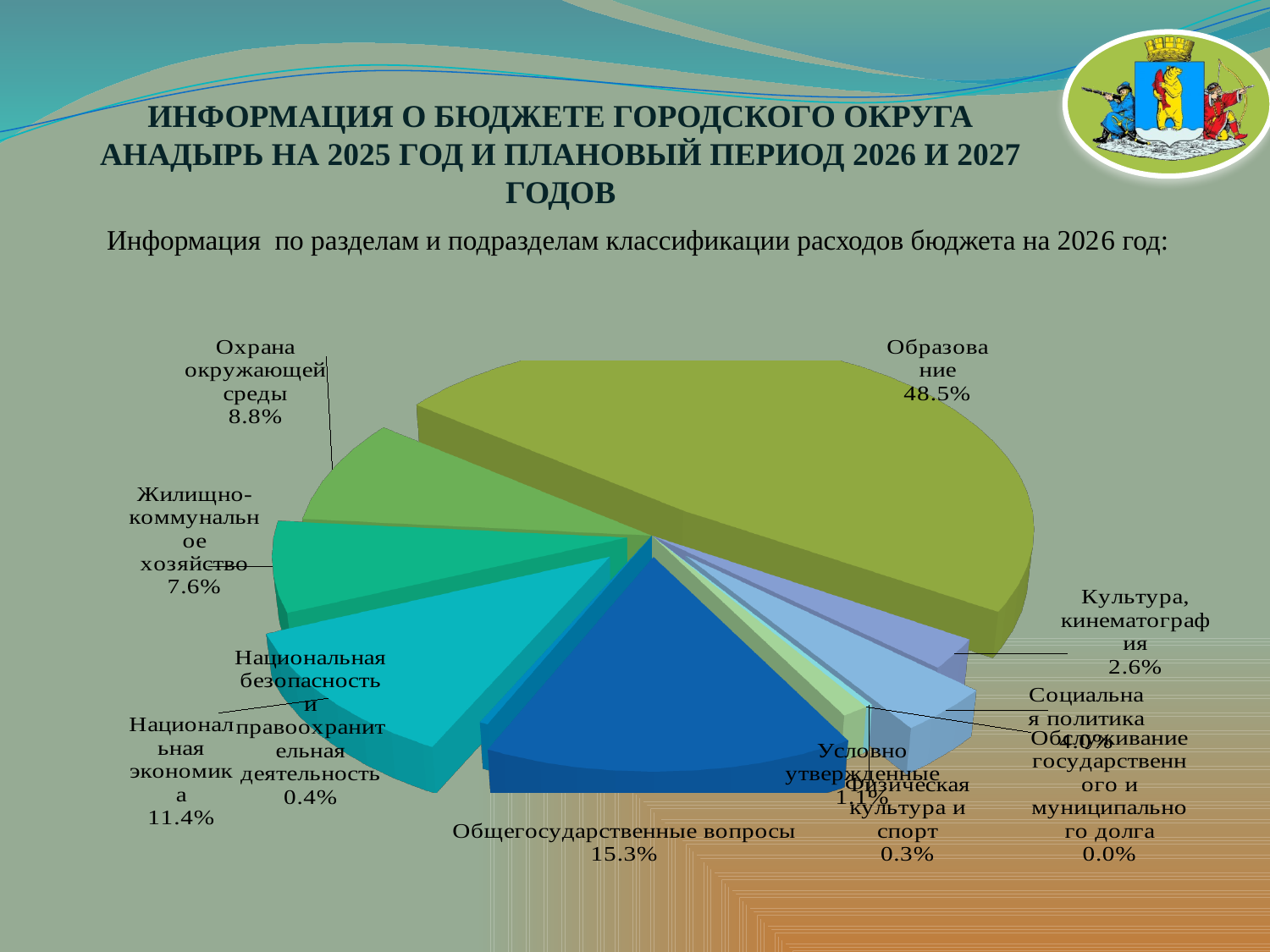
Which is larger, Охрана окружающей среды or Жилищно-коммунальное хозяйство? Охрана окружающей среды What is the value shown for Охрана окружающей среды? 8.8% What is the value shown for Обслуживание государственного и муниципального долга? 0.0% How many categories are shown in the pie chart? 11 What is the value shown for Общегосударственные вопросы? 15.3% What is the difference in percentage points between Образование and Общегосударственные вопросы? 33.2 What is the value shown for Культура, кинематография? 2.6% What is the value shown for Национальная экономика? 11.4% What share of the pie does Образование have? 48.5% Which category has the largest share of the pie? Образование What kind of chart is shown on the slide? pie chart What is the value shown for Жилищно-коммунальное хозяйство? 7.6%